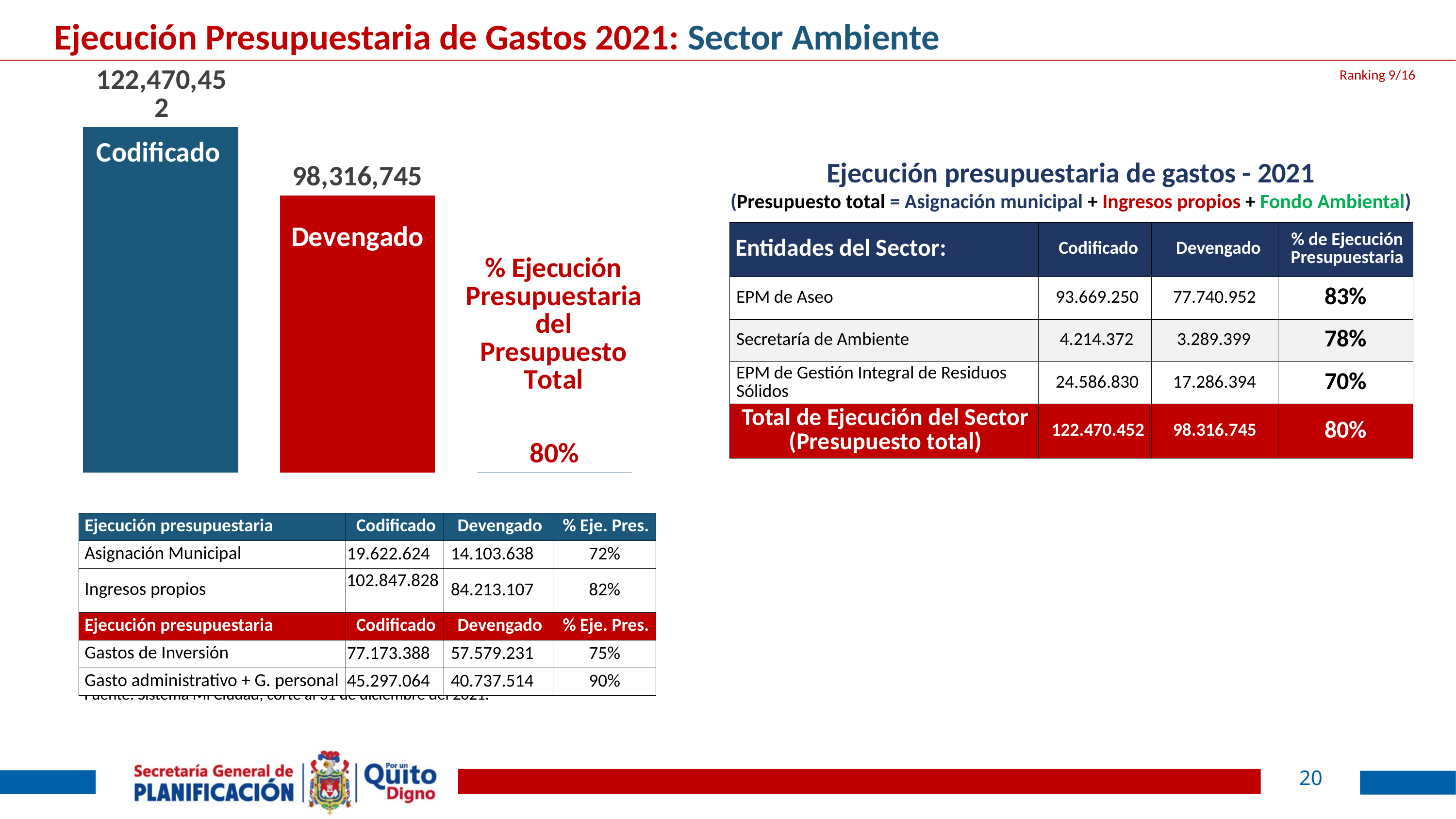
What is the value of the Devengado bar in the bar chart? 98,316,745 How many bars are shown in the chart? 2 What kind of chart is shown on the left of the slide? Bar chart What colour is the Devengado bar in the chart? Red What percentage is shown next to the bar chart as the % Ejecución Presupuestaria del Presupuesto Total? 80% Which bar in the chart is the lowest? Devengado Which bar in the chart is the highest? Codificado Which is larger in the bar chart, Codificado or Devengado? Codificado What is the difference between the Codificado and Devengado values in the bar chart? 24,153,707 What is the value of the Codificado bar in the bar chart? 122,470,452